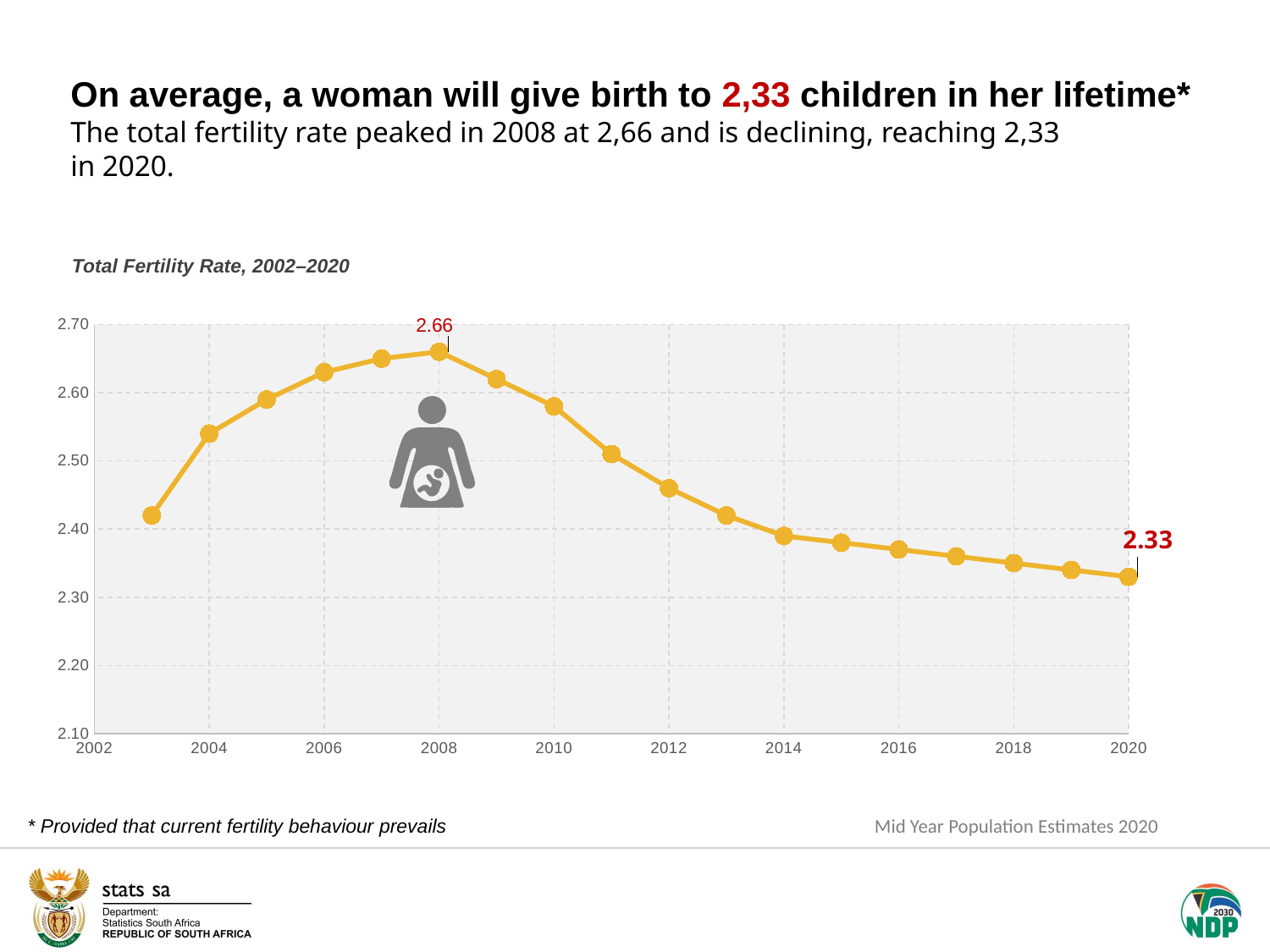
What is the total fertility rate shown for 2020? 2.33 What is the title of the chart? Total Fertility Rate, 2002–2020 Is the value for 2006 greater or less than 2.60? greater Which year has a higher total fertility rate, 2008 or 2020? 2008 Is the value for 2012 greater or less than 2.50? less In which year does the total fertility rate reach its highest value? 2008 What is the total fertility rate shown for 2008? 2.66 What is the difference between the total fertility rate in 2008 and in 2020? 0.33 How does the total fertility rate change from 2008 to 2020? It declines Which year has a higher total fertility rate, 2004 or 2016? 2004 In which year is the total fertility rate at its lowest? 2020 What type of chart is shown on the slide? Line chart